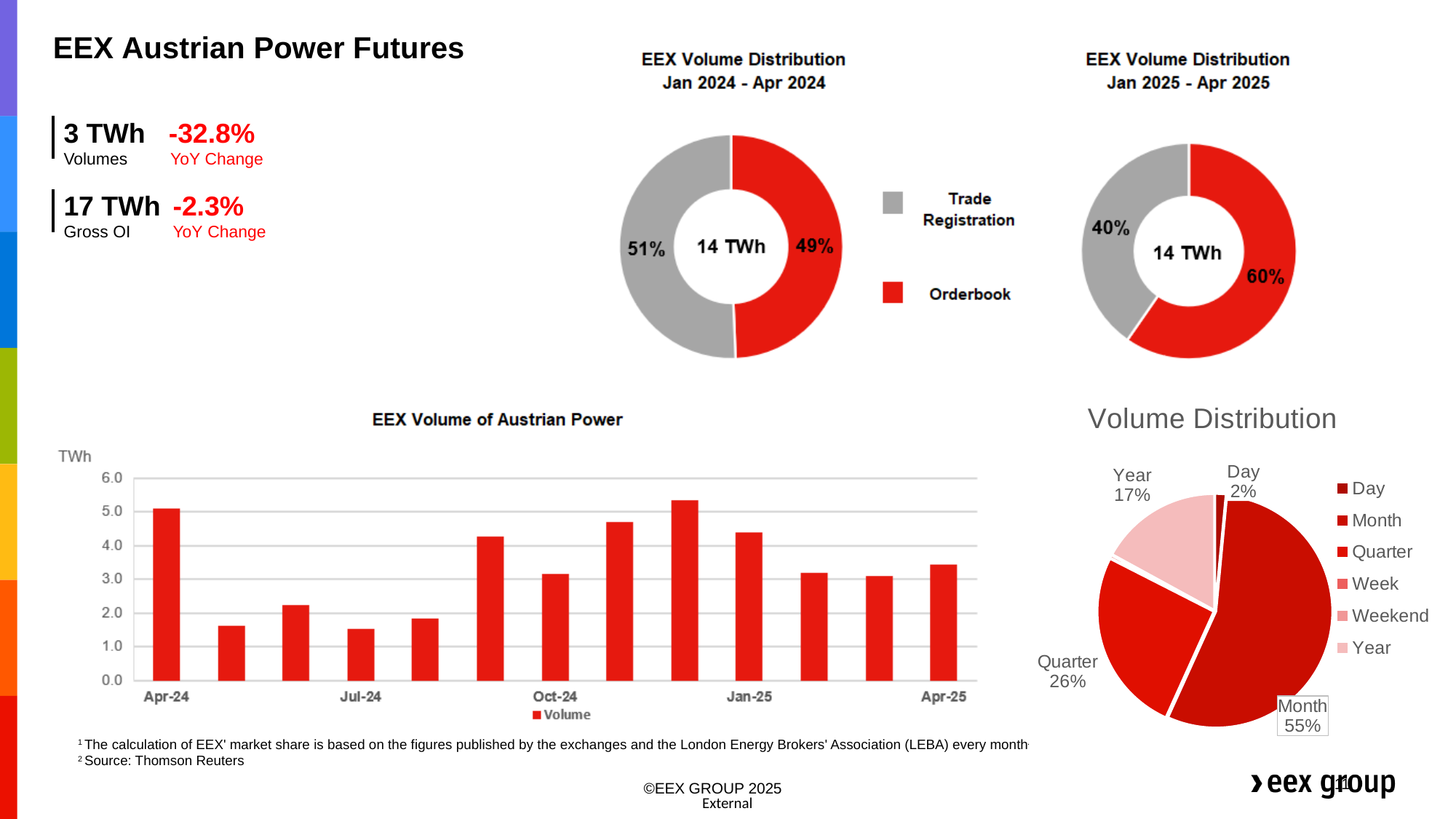
In the EEX Volume of Austrian Power chart, is the value for Apr-24 greater or less than 4.0? greater In the EEX Volume Distribution Jan 2025 - Apr 2025 chart, by how many percentage points does Orderbook exceed Trade Registration? 20 percentage points How many entries does the legend of the Volume Distribution pie chart list? 6 In the Volume Distribution pie chart, which labelled slice is the largest? Month In the EEX Volume Distribution Jan 2024 - Apr 2024 chart, which is larger, Trade Registration or Orderbook? Trade Registration What kind of chart is EEX Volume of Austrian Power? Bar chart In the EEX Volume Distribution Jan 2025 - Apr 2025 chart, what total volume is shown in the centre of the donut? 14 TWh In the EEX Volume Distribution Jan 2025 - Apr 2025 chart, what share is Orderbook? 60% In the Volume Distribution pie chart, what share does Month have? 55% In the EEX Volume Distribution Jan 2024 - Apr 2024 chart, what share is Trade Registration? 51% In the EEX Volume of Austrian Power chart, which is larger, the value for Apr-24 or the value for Apr-25? Apr-24 In the Volume Distribution pie chart, which labelled slice is the smallest? Day